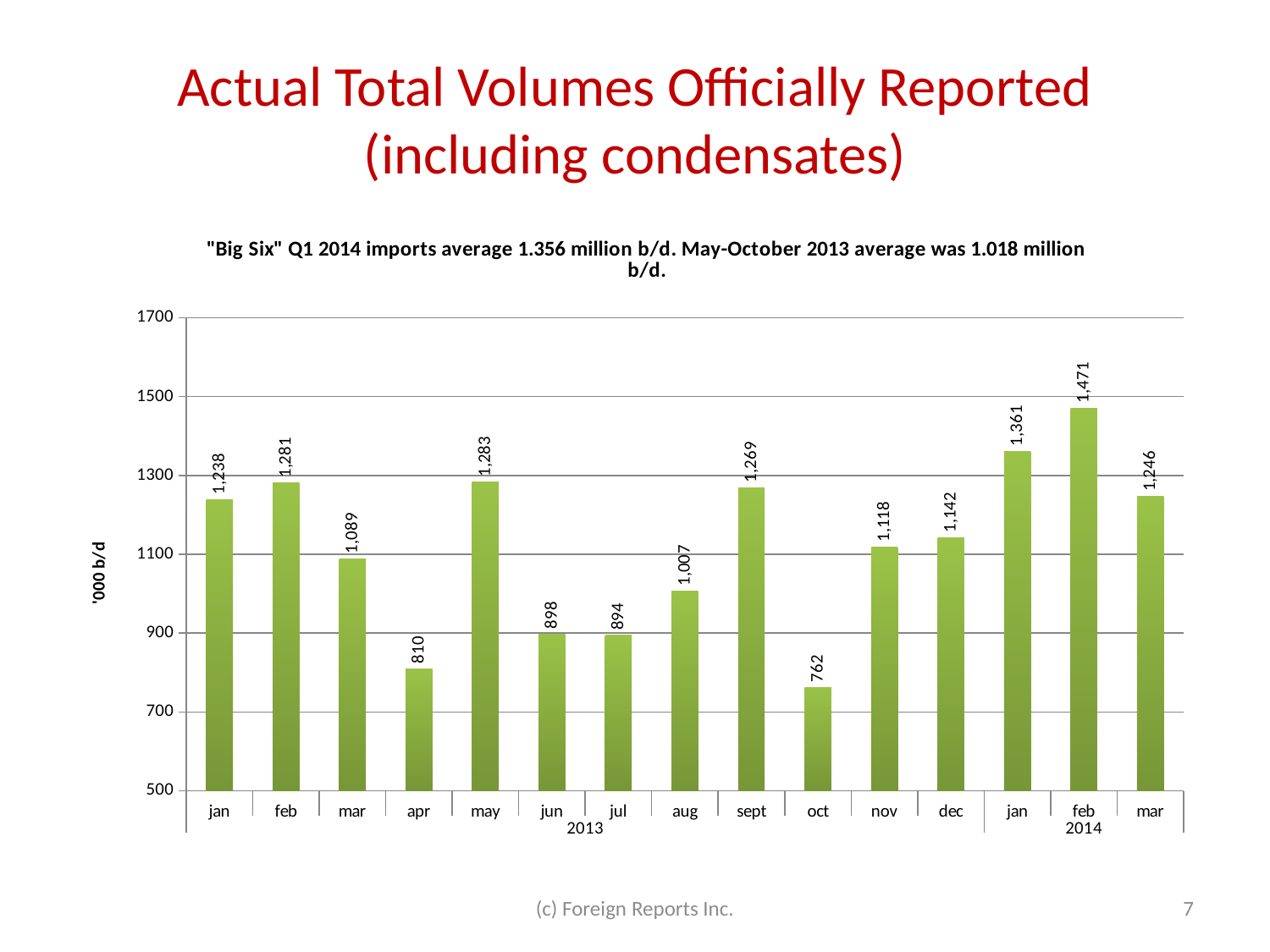
What kind of chart is shown on the slide? bar chart What is the value for feb 2014? 1,471 Do the values rise or fall from oct 2013 to feb 2014? rise Which month has the highest value? feb 2014 Which month has the lowest value? oct 2013 What is the value for oct 2013? 762 What is the label on the vertical axis of the chart? '000 b/d How many months are plotted on the chart? 15 Which is larger, the value for may 2013 or the value for sept 2013? may 2013 What is the value for apr 2013? 810 What is the difference between the values for feb 2014 and jan 2014? 110 Is the value for nov 2013 greater or less than 1100? greater